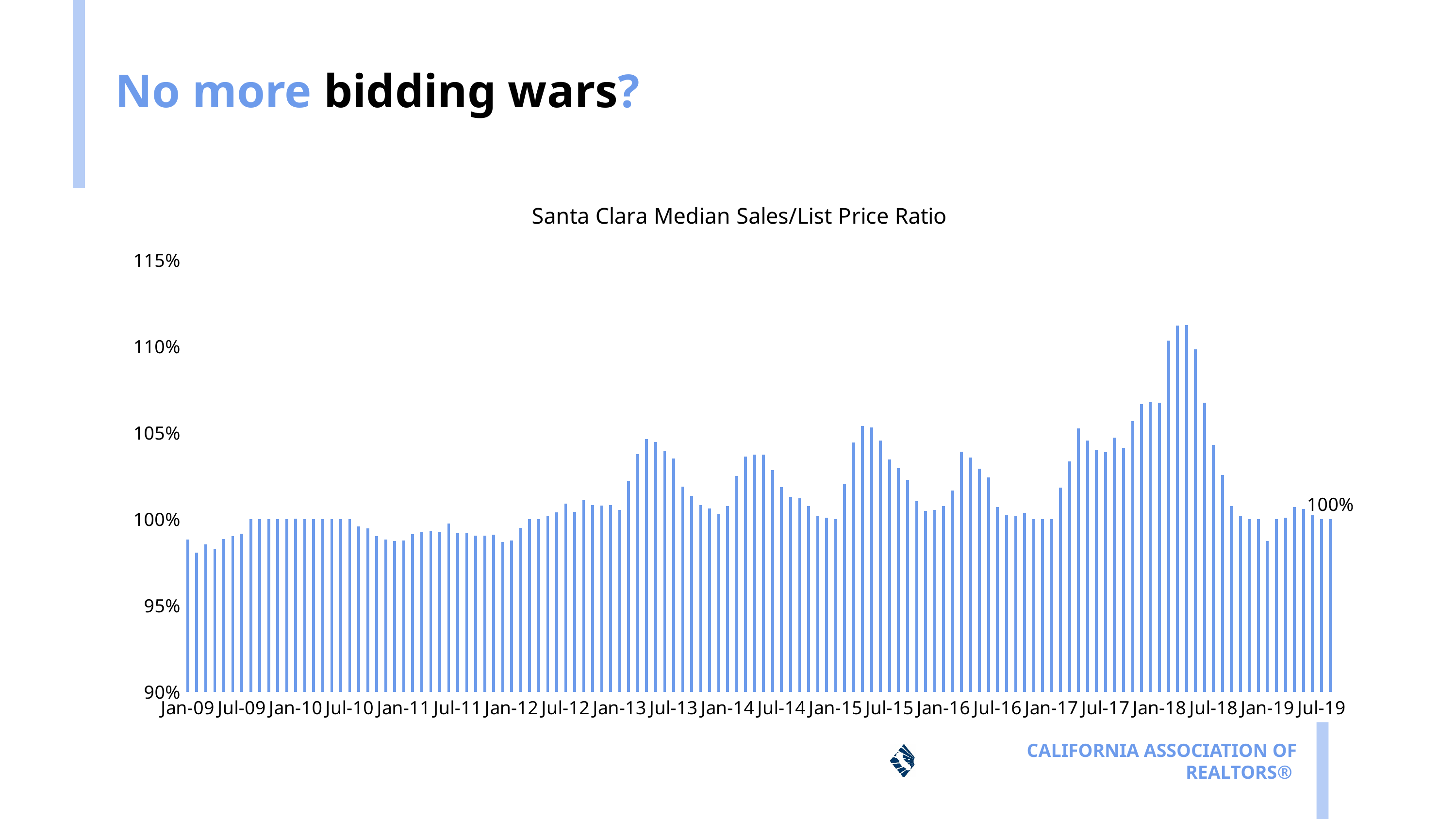
Is the value for Jul-15 greater or less than 100%? greater Which is larger, the value for Jan-18 or the value for Jan-19? Jan-18 In which year does the chart reach its highest value? 2018 Is the value for Jan-09 greater or less than 95%? greater Which is larger, the value for Jul-13 or the value for Jul-12? Jul-13 What are the lowest and highest values shown on the vertical axis? 90% and 115% What value is printed on the data label at the right end of the chart? 100% What kind of chart is shown on the slide? Bar chart Is the highest bar on the chart greater or less than 110%? greater What is the title of the chart? Santa Clara Median Sales/List Price Ratio Do the values rise or fall between Jan-18 and Jan-19? fall Do the values rise or fall between Jan-17 and Jan-18? rise